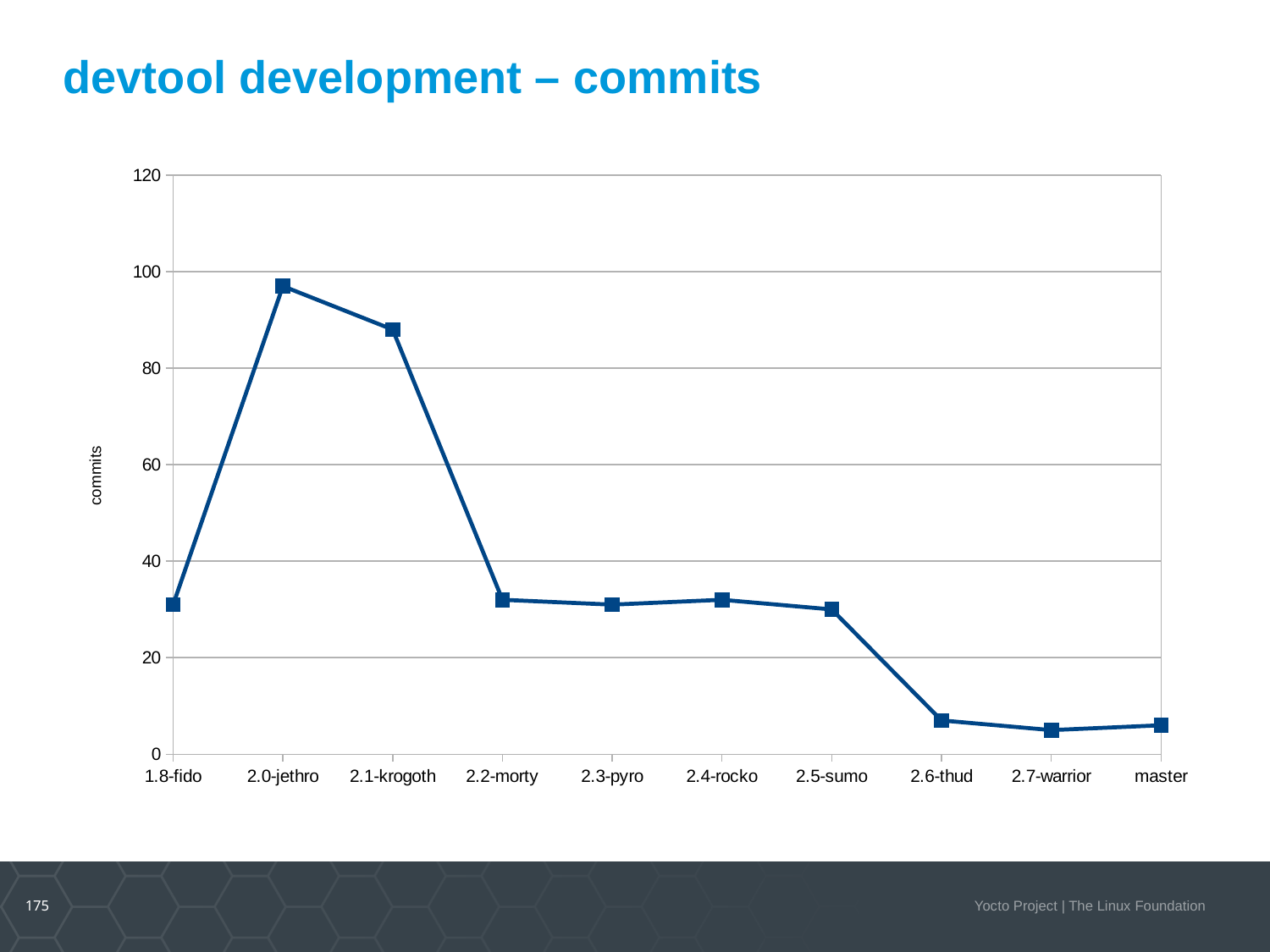
What kind of chart is shown on the slide? line chart Do the commits rise or fall from 2.5-sumo to 2.6-thud? fall Which has more commits, 2.2-morty or 2.6-thud? 2.2-morty Is the value for master greater or less than 20? less Which has more commits, 2.0-jethro or 2.1-krogoth? 2.0-jethro What is the label on the y axis? commits How many releases are plotted along the x axis? 10 Is the value for 2.0-jethro greater or less than 80? greater Is the value for 1.8-fido greater or less than 40? less Which release has the highest number of commits? 2.0-jethro